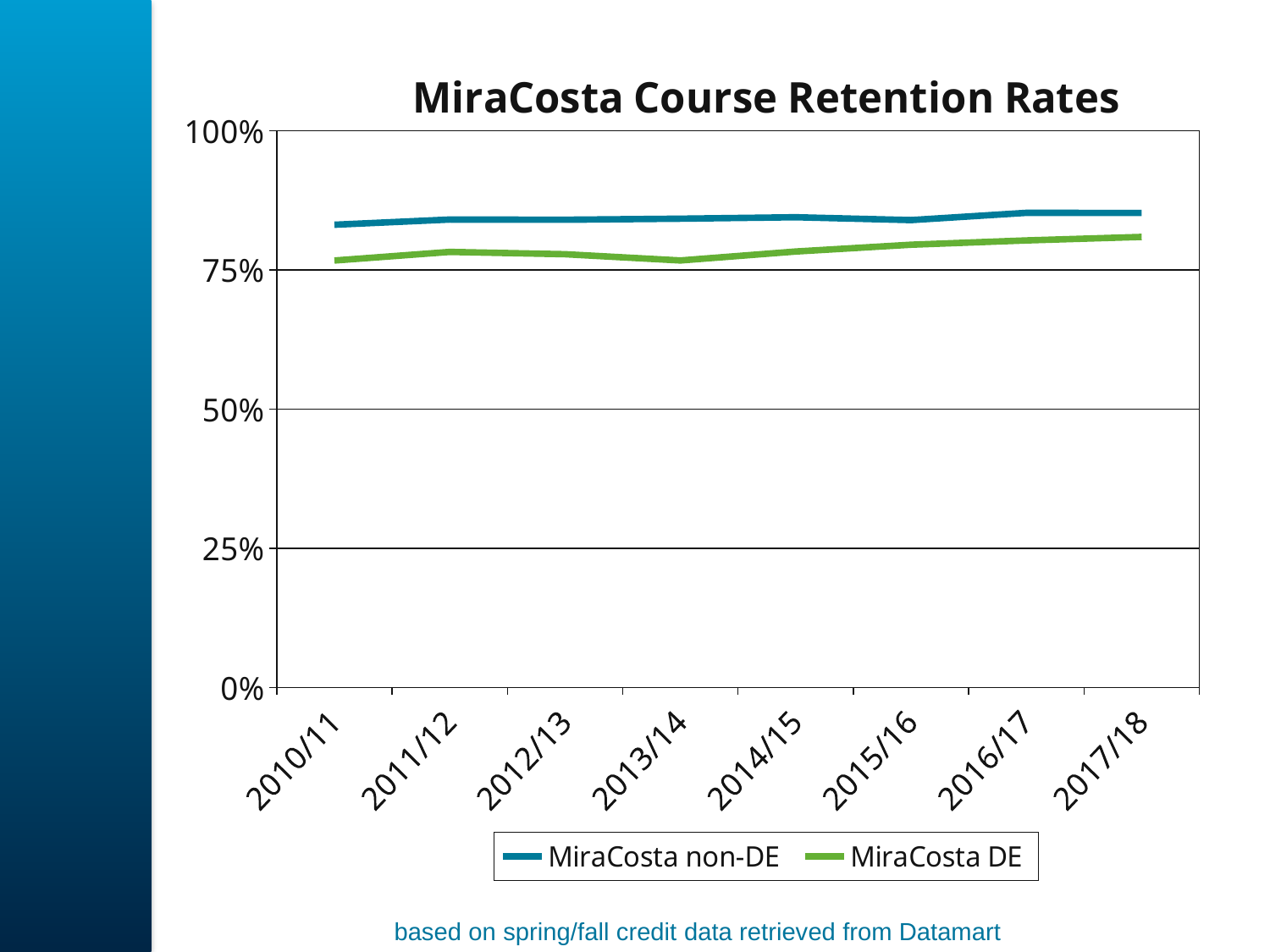
Is the value for MiraCosta non-DE in 2017/18 greater or less than 100%? less What is the title of the chart? MiraCosta Course Retention Rates How many series does the legend list? 2 How many academic years are plotted along the x axis? 8 What kind of chart is shown on the slide? line chart Which series is drawn with the green line? MiraCosta DE Which series is higher across every year shown, MiraCosta non-DE or MiraCosta DE? MiraCosta non-DE In 2013/14, which series has the higher retention rate, MiraCosta non-DE or MiraCosta DE? MiraCosta non-DE Does the MiraCosta DE retention rate rise or fall from 2013/14 to 2017/18? rise Is the value for MiraCosta DE in 2011/12 greater or less than 50%? greater Is the value for MiraCosta DE in 2017/18 greater or less than 75%? greater